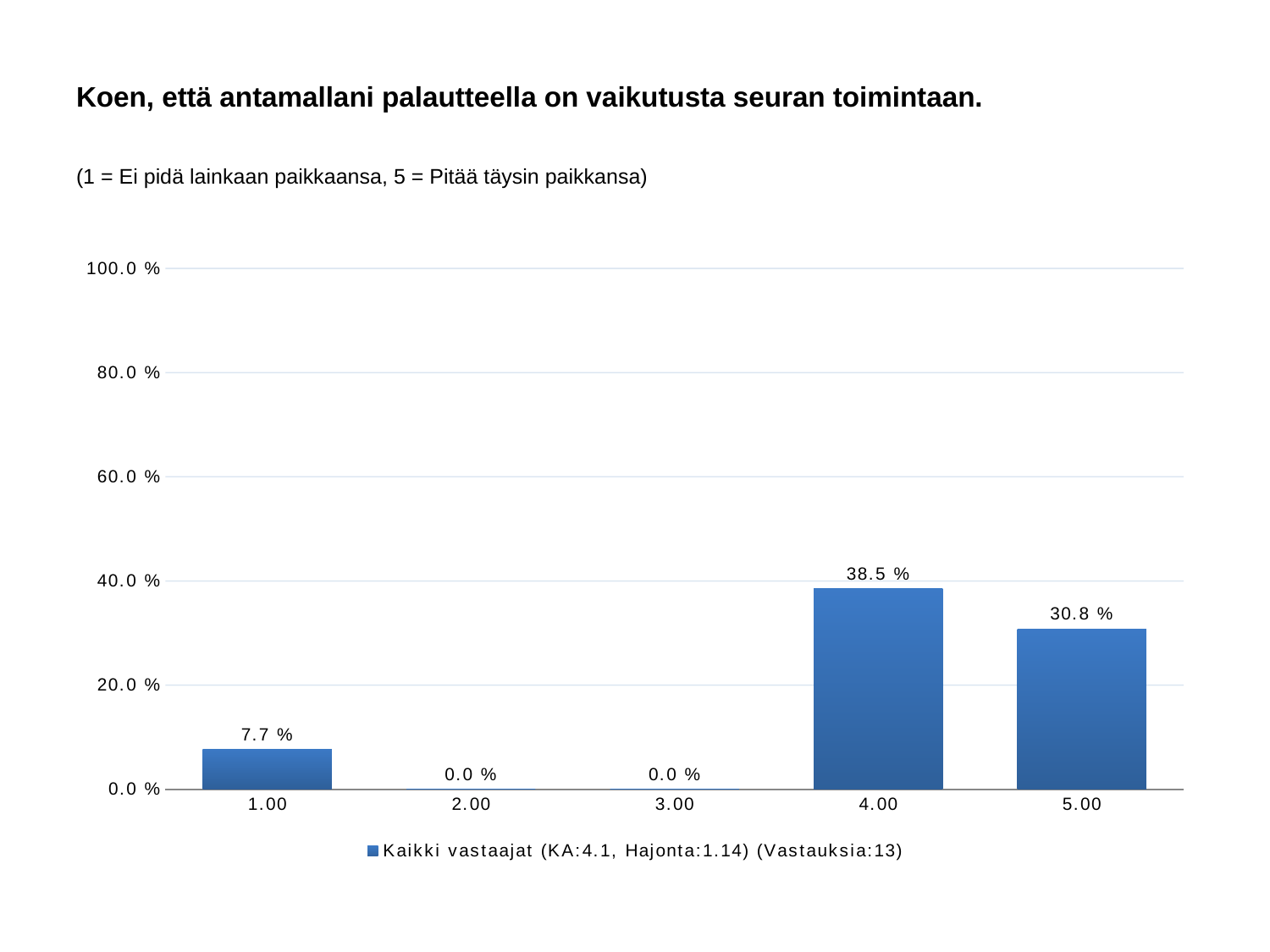
How many categories are shown on the x axis? 5 How many series does the legend list? 1 How many categories have a value of 0.0 %? 2 What is the value for category 5.00? 30.8 % What is the difference between the values for 4.00 and 5.00? 7.7 % What is the value for category 1.00? 7.7 % Is the value for 4.00 greater or less than 20.0 %? greater What kind of chart is shown? bar chart Which is larger, the value for 1.00 or the value for 5.00? 5.00 What is the value for category 4.00? 38.5 % What is the value for category 2.00? 0.0 % Which category has the highest value? 4.00